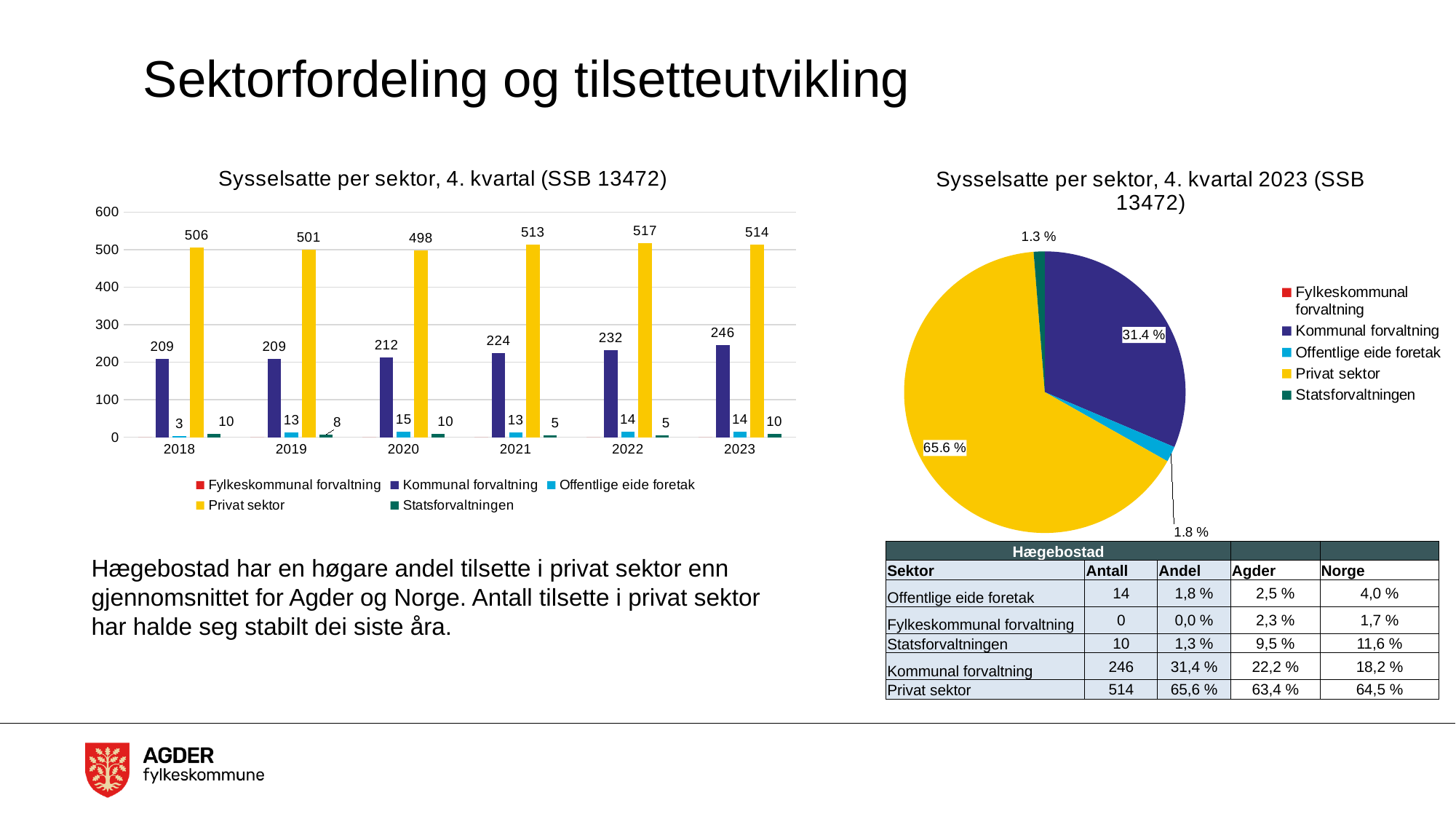
In the bar chart 'Sysselsatte per sektor, 4. kvartal (SSB 13472)', is the Statsforvaltningen value for 2019 larger or smaller than the value for 2021? larger In the bar chart 'Sysselsatte per sektor, 4. kvartal (SSB 13472)', what is the value for Kommunal forvaltning in 2023? 246 In the bar chart 'Sysselsatte per sektor, 4. kvartal (SSB 13472)', in which year is the Privat sektor value highest? 2022 What kind of chart is the chart on the right of the slide? pie chart In the bar chart 'Sysselsatte per sektor, 4. kvartal (SSB 13472)', does the Kommunal forvaltning value rise or fall from 2020 to 2023? rise In the bar chart 'Sysselsatte per sektor, 4. kvartal (SSB 13472)', in which year is the Privat sektor value lowest? 2020 In the pie chart 'Sysselsatte per sektor, 4. kvartal 2023 (SSB 13472)', what share does Privat sektor have? 65.6 % In the bar chart 'Sysselsatte per sektor, 4. kvartal (SSB 13472)', how many series does the legend list? 5 In the bar chart 'Sysselsatte per sektor, 4. kvartal (SSB 13472)', how many years are shown on the x axis? 6 In the bar chart 'Sysselsatte per sektor, 4. kvartal (SSB 13472)', what is the value for Offentlige eide foretak in 2018? 3 In the bar chart 'Sysselsatte per sektor, 4. kvartal (SSB 13472)', what is the difference between the Kommunal forvaltning values for 2023 and 2018? 37 In the bar chart 'Sysselsatte per sektor, 4. kvartal (SSB 13472)', what is the value for Privat sektor in 2022? 517